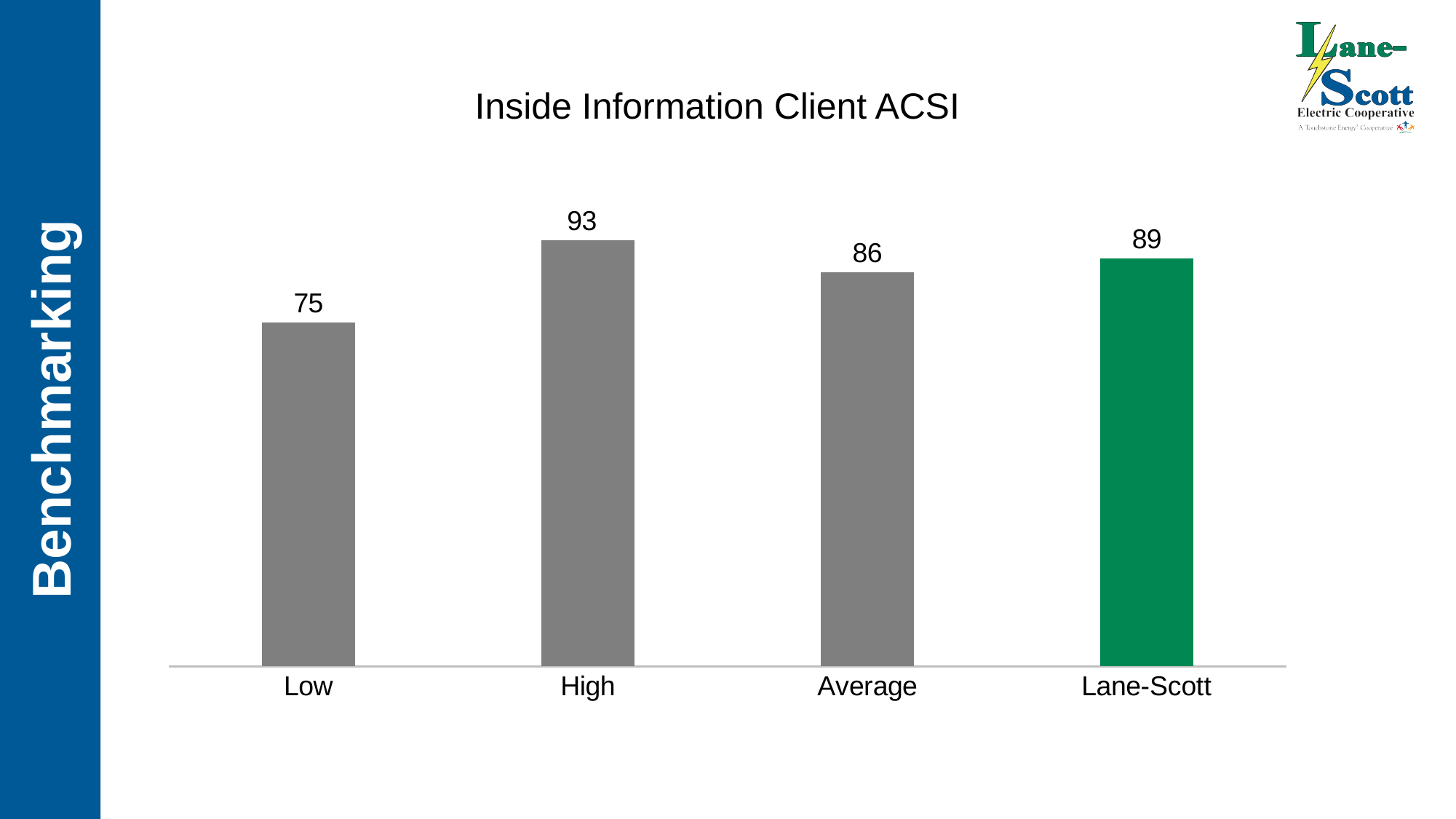
What is the value for Low? 75 What is the value for Lane-Scott? 89 What is the value for High? 93 Which category has the lowest value? Low Which category has the highest value? High Which is larger, the value for Lane-Scott or the value for Average? Lane-Scott How much higher is the Lane-Scott value than the Average value? 3 What is the title of the chart? Inside Information Client ACSI What is the difference between the High value and the Low value? 18 What is the value for Average? 86 What kind of chart is shown on the slide? Bar chart How many categories are shown on the chart? 4